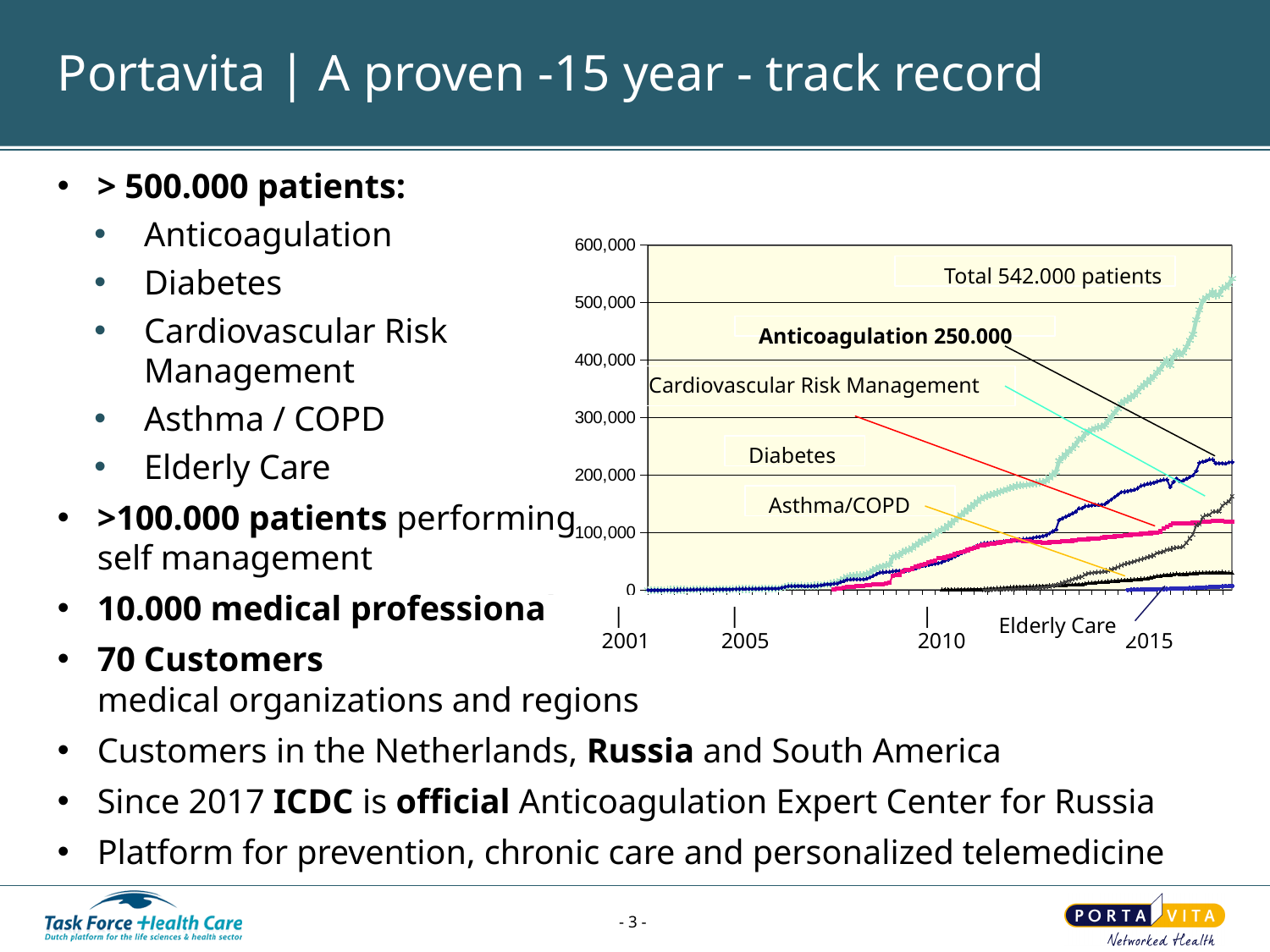
How many series are labelled on the chart? 6 At the right end of the chart, which is larger: Anticoagulation or Diabetes? Anticoagulation Which labelled series is the lowest at the right end of the chart? Elderly Care Is the value of the Anticoagulation line at the right end of the chart greater or less than 300,000? less According to the label on the chart, what is the total number of patients? 542.000 patients What is the highest value shown on the vertical axis of the chart? 600,000 What kind of chart is shown on the slide? line chart According to the label on the chart, what is the number of patients for Anticoagulation? 250.000 Is the value of the Cardiovascular Risk Management line at the right end of the chart greater or less than 200,000? less Does the Total line rise or fall from 2001 to 2015? rise Is the value of the Total line at 2015 greater or less than 500,000? less Which line is the highest at the right end of the chart? Total